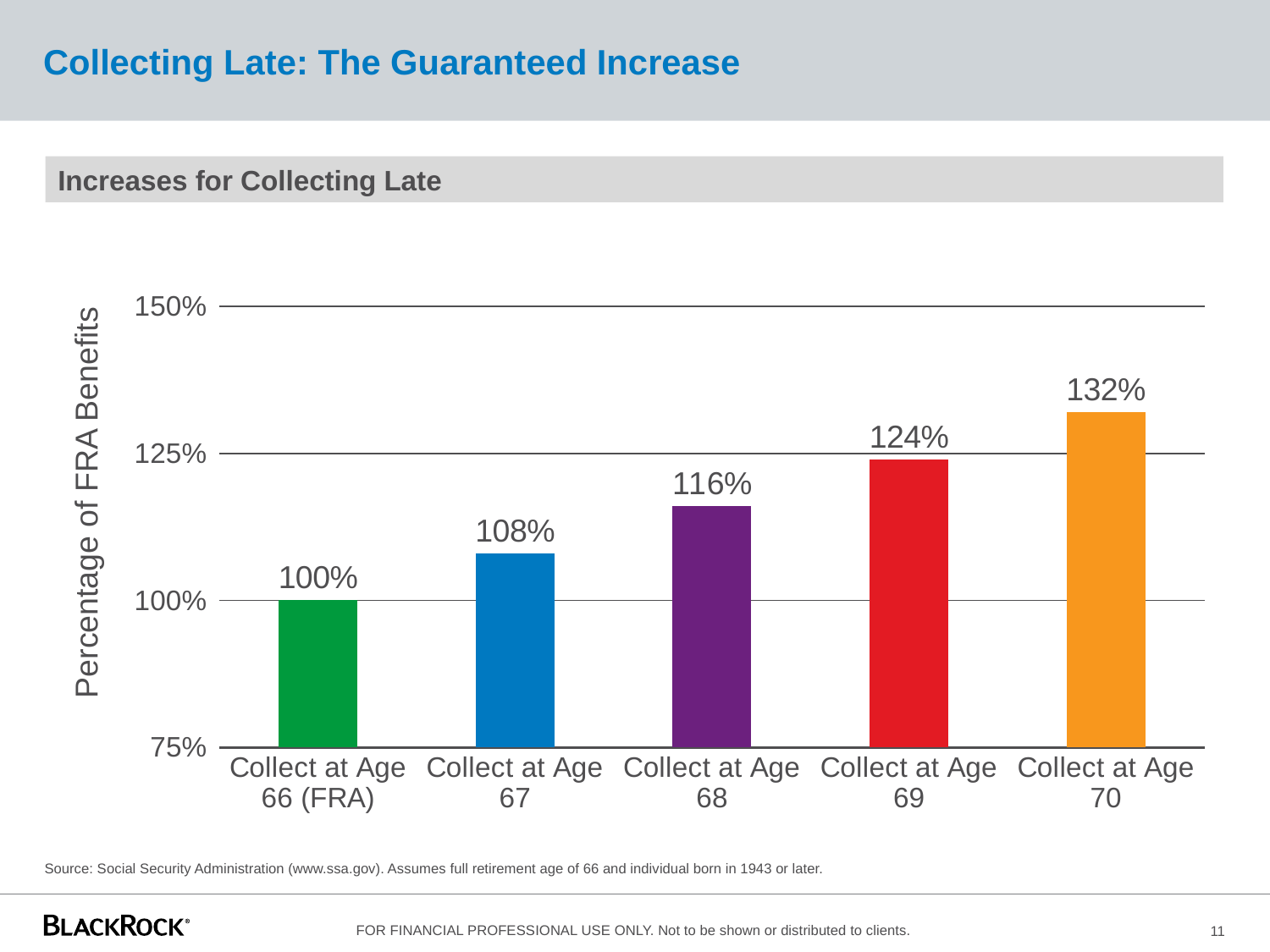
What kind of chart is shown on the slide? bar chart How many categories are shown on the x axis? 5 What is the value for Collect at Age 68? 116% Which category has the highest value? Collect at Age 70 Which category has the lowest value? Collect at Age 66 (FRA) Which is larger, the value for Collect at Age 67 or Collect at Age 69? Collect at Age 69 What is the value for Collect at Age 70? 132% What is the difference between the values for Collect at Age 69 and Collect at Age 67? 16% Do the values rise or fall from left to right along the x axis? rise What is the difference between the values for Collect at Age 70 and Collect at Age 66 (FRA)? 32% What is the value for Collect at Age 66 (FRA)? 100% Is the value for Collect at Age 69 greater or less than 125%? less